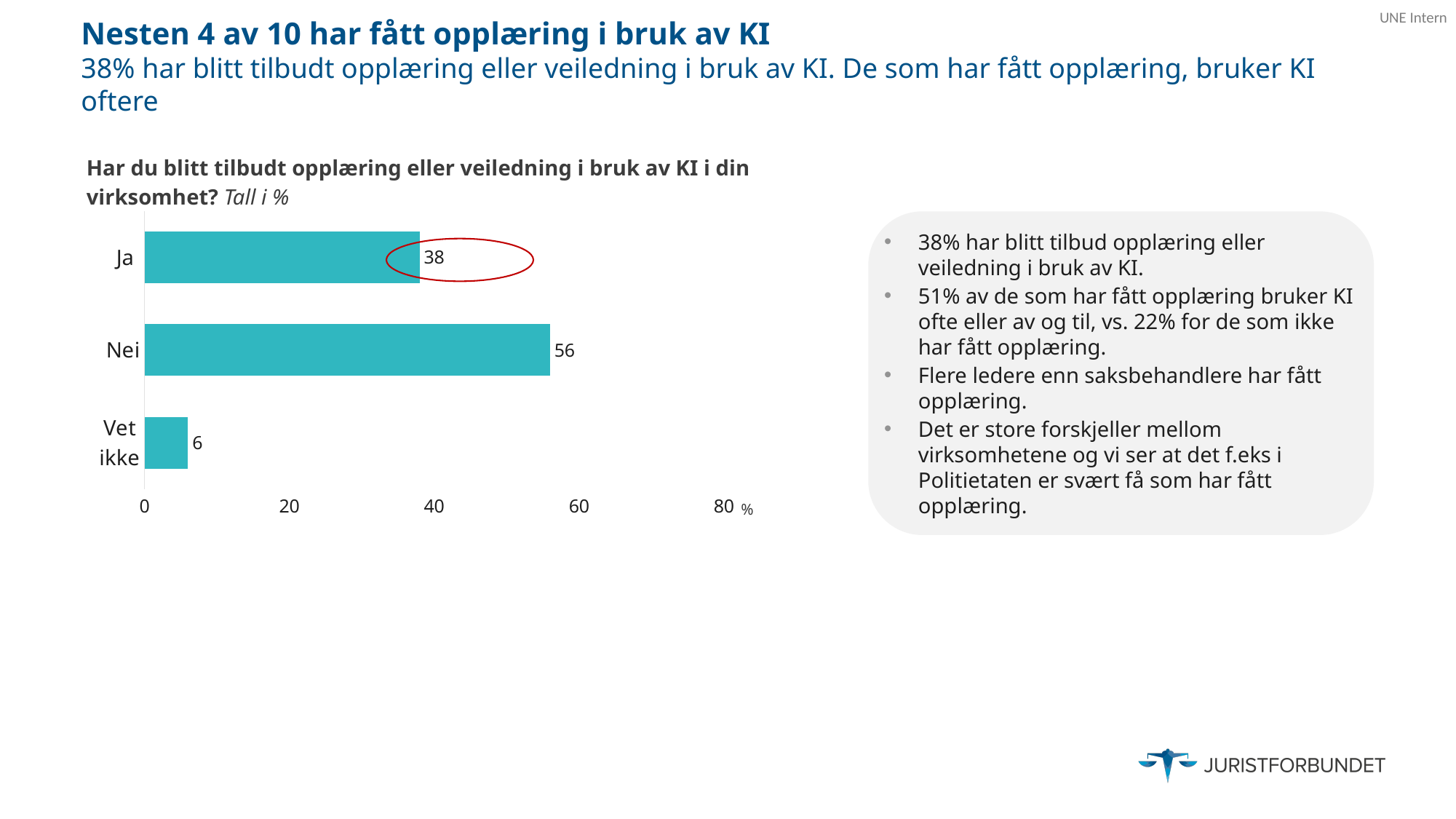
Which category has the lowest value in the chart? Vet ikke What is the difference between the values for "Nei" and "Ja"? 18 What is the value for "Vet ikke" in the chart? 6 Which is larger, the value for "Ja" or the value for "Nei"? Nei What is the value for "Ja" in the chart? 38 Which category's data label is circled in red on the chart? Ja What kind of chart is shown on the slide? bar chart How many categories are shown in the chart? 3 Is the value for "Nei" greater or less than 40? greater Which category has the highest value in the chart? Nei What is the value for "Nei" in the chart? 56 What is the difference between the values for "Ja" and "Vet ikke"? 32